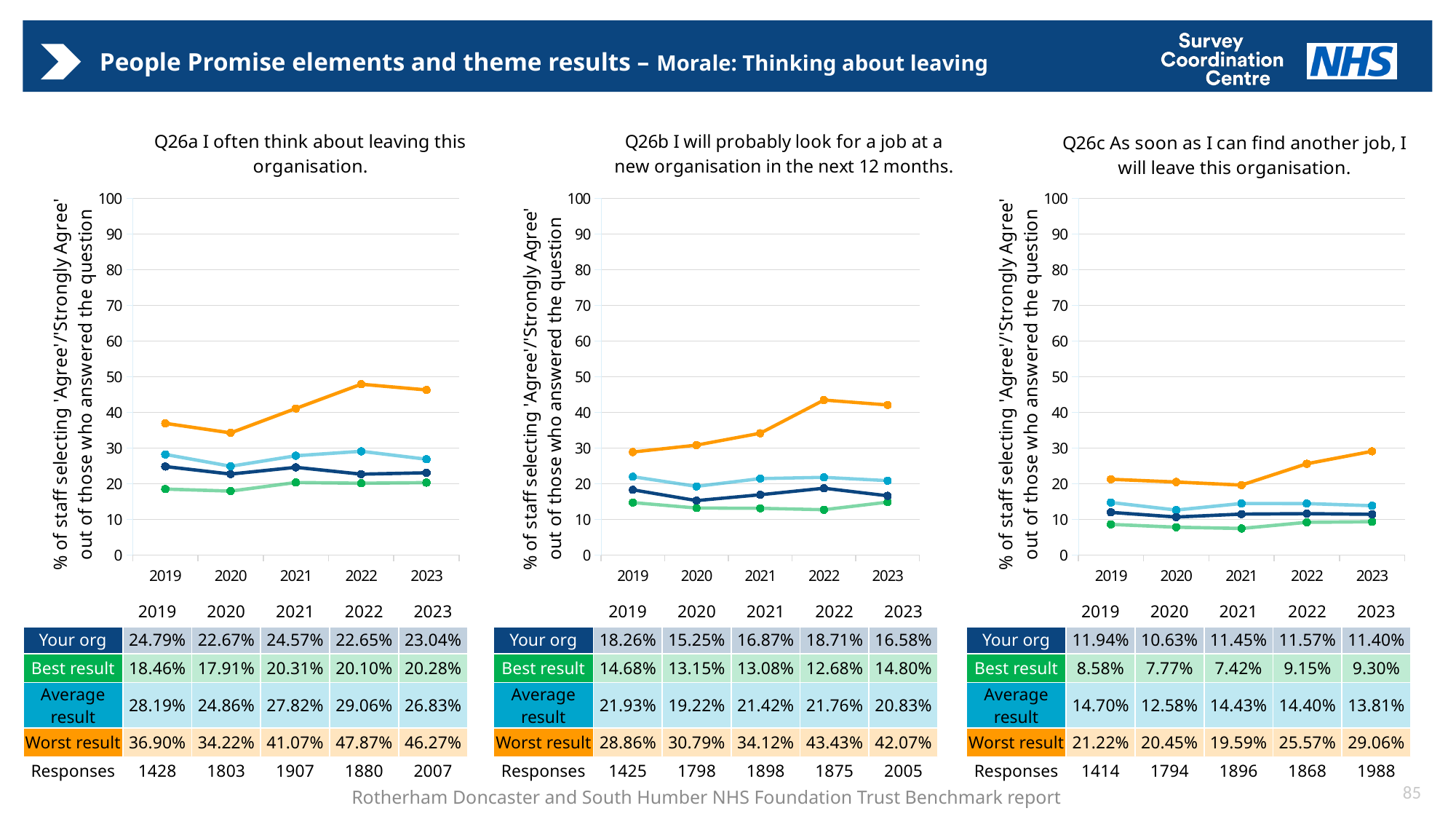
In the Q26b chart, what is the difference between the 'Average result' and 'Your org' values for 2023? 4.25% In the Q26b chart, does the 'Worst result' line rise or fall from 2019 to 2022? rise In the Q26b chart, what is the 'Worst result' value for 2022? 43.43% How many years are plotted on the x axis of the Q26b chart? 5 What kind of chart is used for Q26a? line chart In the Q26a chart, which year has the highest 'Worst result' value? 2022 In the Q26c chart, which year has the lowest 'Best result' value? 2021 In the Q26c chart, what is the 'Average result' value for 2019? 14.70% In the Q26a chart, what is the 'Your org' value for 2023? 23.04% In the Q26c chart, is the 'Worst result' value for 2023 greater or less than 20? greater In the Q26c chart, how many responses were recorded for 2023? 1988 In the Q26a chart, is the 'Your org' value for 2019 larger or smaller than the 'Your org' value for 2020? larger